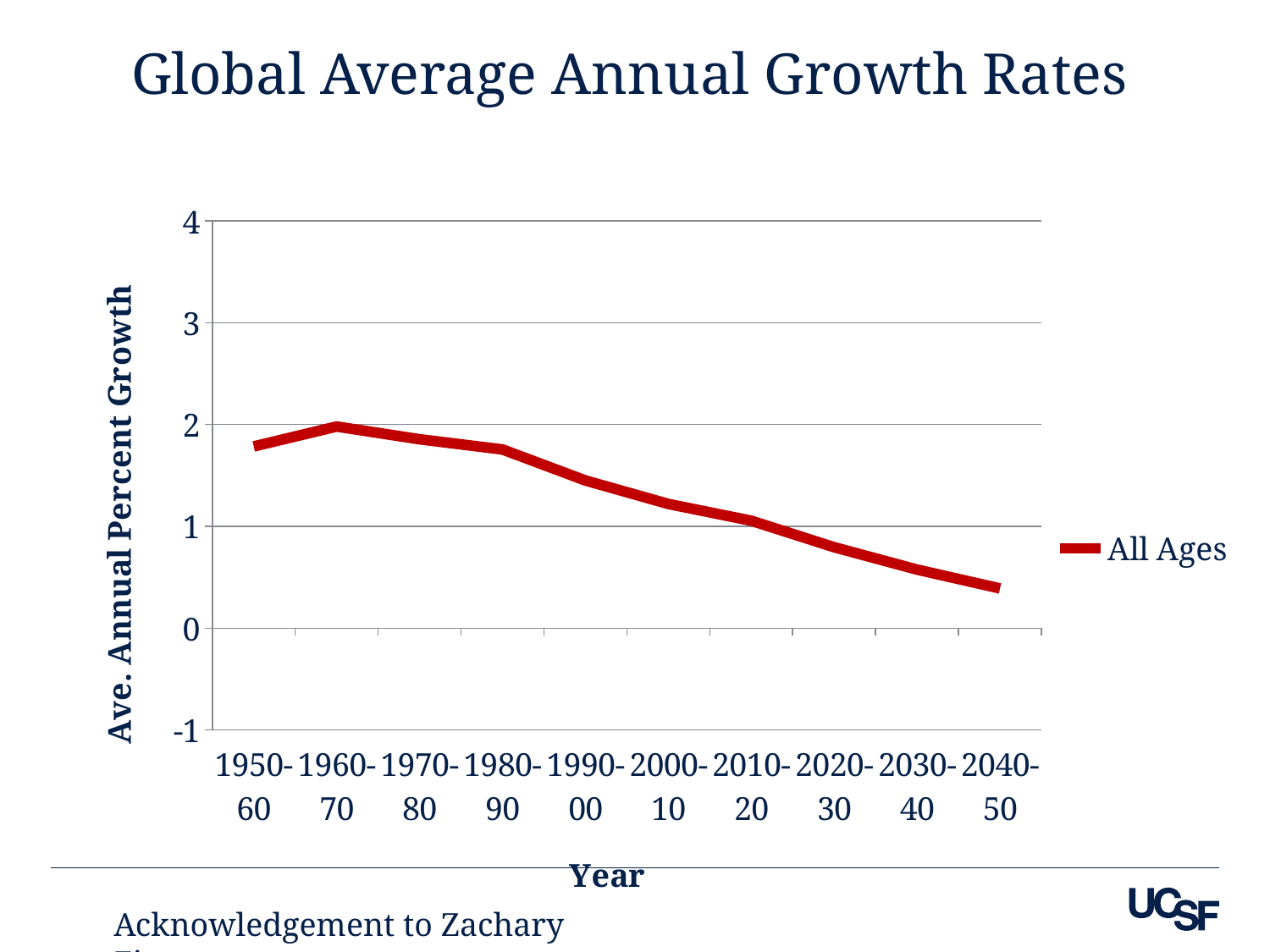
Is the value for 2040-50 greater or less than 1? less Is the value for 1950-60 greater or less than 1? greater Do the values generally rise or fall from 1960-70 to 2040-50? fall Which period has the highest average annual percent growth? 1960-70 How many series does the legend list? 1 Is the value for 1960-70 greater or less than 3? less How many time periods are plotted along the x axis? 10 Which period has the lowest average annual percent growth? 2040-50 Which is larger, the value for 1950-60 or the value for 2030-40? 1950-60 What is the name of the series shown in the legend? All Ages What kind of chart is shown on the slide? Line chart What is the title of the chart? Global Average Annual Growth Rates